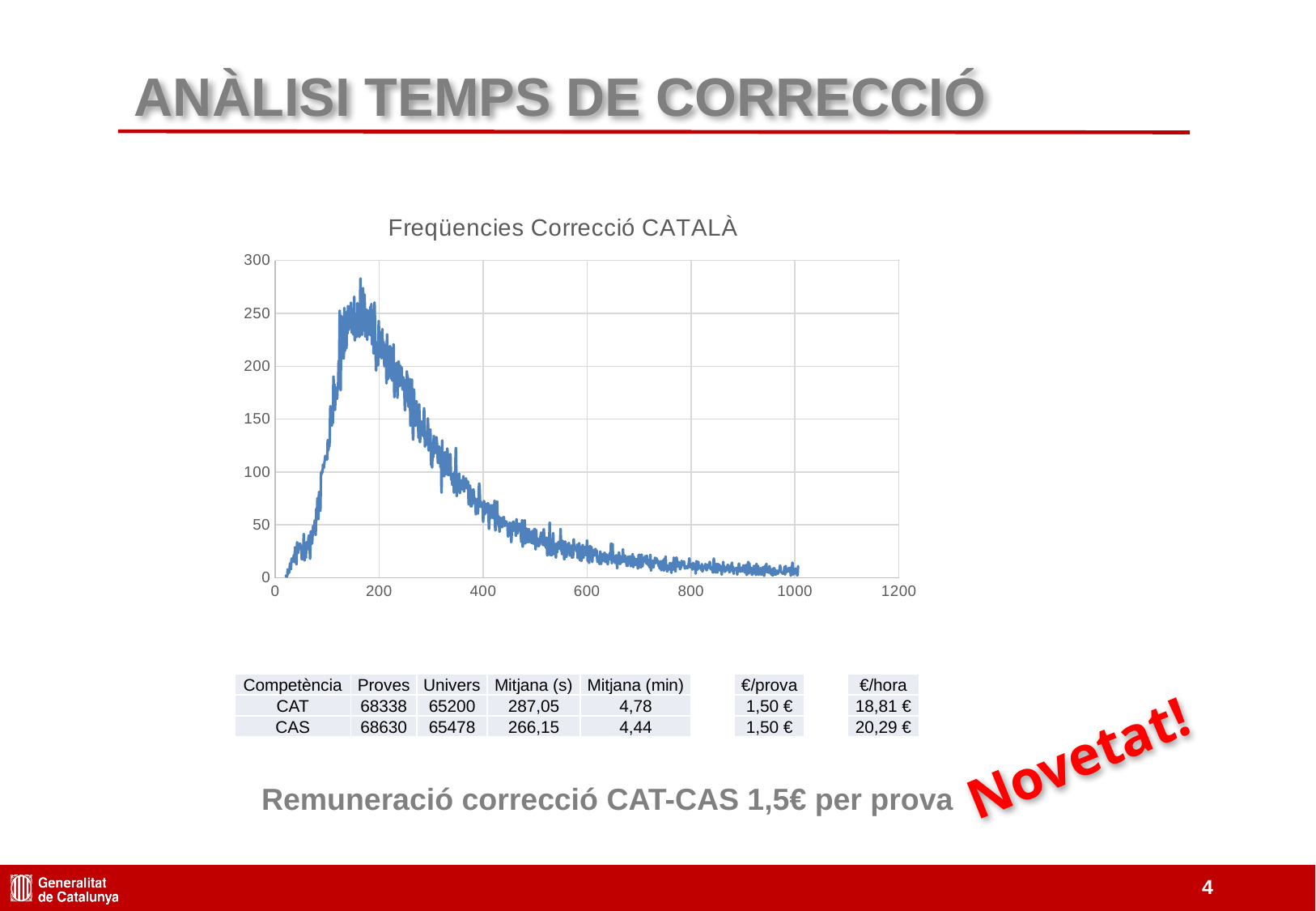
What is the title of the chart? Freqüencies Correcció CATALÀ Is the value of the line at x = 800 greater or less than 50? less Which is larger, the value of the line at x = 200 or at x = 600? x = 200 What kind of chart is shown on the slide? line chart How many data series are plotted in the chart? 1 Is the value of the line at x = 400 greater or less than 100? less Is the value of the line at x = 600 greater or less than 50? less Do the values rise or fall along the x axis between x = 200 and x = 1000? fall What is the highest value shown on the y axis? 300 Do the values rise or fall along the x axis between x = 0 and x = 150? rise